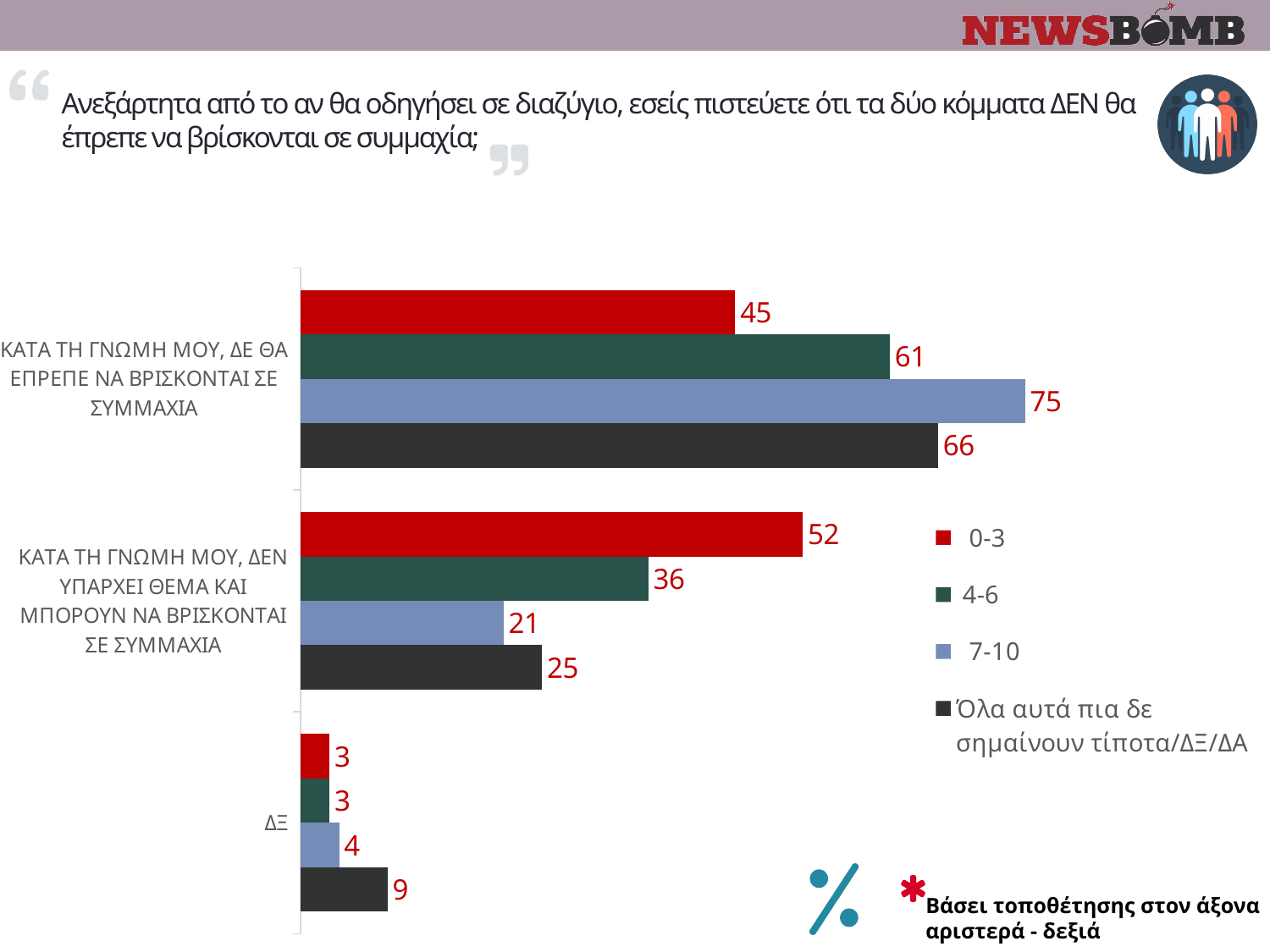
What colour are the bars for the 0-3 series? red What is the value of the "Όλα αυτά πια δε σημαίνουν τίποτα/ΔΞ/ΔΑ" series for the category ΔΞ? 9 What kind of chart is shown on the slide? bar chart What is the value of the 0-3 series for the category "ΚΑΤΑ ΤΗ ΓΝΩΜΗ ΜΟΥ, ΔΕΝ ΥΠΑΡΧΕΙ ΘΕΜΑ ΚΑΙ ΜΠΟΡΟΥΝ ΝΑ ΒΡΙΣΚΟΝΤΑΙ ΣΕ ΣΥΜΜΑΧΙΑ"? 52 What is the difference between the 7-10 value and the 0-3 value for the category "ΚΑΤΑ ΤΗ ΓΝΩΜΗ ΜΟΥ, ΔΕ ΘΑ ΕΠΡΕΠΕ ΝΑ ΒΡΙΣΚΟΝΤΑΙ ΣΕ ΣΥΜΜΑΧΙΑ"? 30 Which series has the lowest value for the category "ΚΑΤΑ ΤΗ ΓΝΩΜΗ ΜΟΥ, ΔΕΝ ΥΠΑΡΧΕΙ ΘΕΜΑ ΚΑΙ ΜΠΟΡΟΥΝ ΝΑ ΒΡΙΣΚΟΝΤΑΙ ΣΕ ΣΥΜΜΑΧΙΑ"? 7-10 What is the value of the 7-10 series for the category "ΚΑΤΑ ΤΗ ΓΝΩΜΗ ΜΟΥ, ΔΕ ΘΑ ΕΠΡΕΠΕ ΝΑ ΒΡΙΣΚΟΝΤΑΙ ΣΕ ΣΥΜΜΑΧΙΑ"? 75 For the 4-6 series, which category has the larger value: "ΚΑΤΑ ΤΗ ΓΝΩΜΗ ΜΟΥ, ΔΕ ΘΑ ΕΠΡΕΠΕ ΝΑ ΒΡΙΣΚΟΝΤΑΙ ΣΕ ΣΥΜΜΑΧΙΑ" or "ΚΑΤΑ ΤΗ ΓΝΩΜΗ ΜΟΥ, ΔΕΝ ΥΠΑΡΧΕΙ ΘΕΜΑ ΚΑΙ ΜΠΟΡΟΥΝ ΝΑ ΒΡΙΣΚΟΝΤΑΙ ΣΕ ΣΥΜΜΑΧΙΑ"? ΚΑΤΑ ΤΗ ΓΝΩΜΗ ΜΟΥ, ΔΕ ΘΑ ΕΠΡΕΠΕ ΝΑ ΒΡΙΣΚΟΝΤΑΙ ΣΕ ΣΥΜΜΑΧΙΑ What is the difference between the 0-3 value and the 4-6 value for the category "ΚΑΤΑ ΤΗ ΓΝΩΜΗ ΜΟΥ, ΔΕΝ ΥΠΑΡΧΕΙ ΘΕΜΑ ΚΑΙ ΜΠΟΡΟΥΝ ΝΑ ΒΡΙΣΚΟΝΤΑΙ ΣΕ ΣΥΜΜΑΧΙΑ"? 16 Which series has the highest value for the category "ΚΑΤΑ ΤΗ ΓΝΩΜΗ ΜΟΥ, ΔΕ ΘΑ ΕΠΡΕΠΕ ΝΑ ΒΡΙΣΚΟΝΤΑΙ ΣΕ ΣΥΜΜΑΧΙΑ"? 7-10 How many series does the legend list? 4 How many categories are shown on the chart? 3